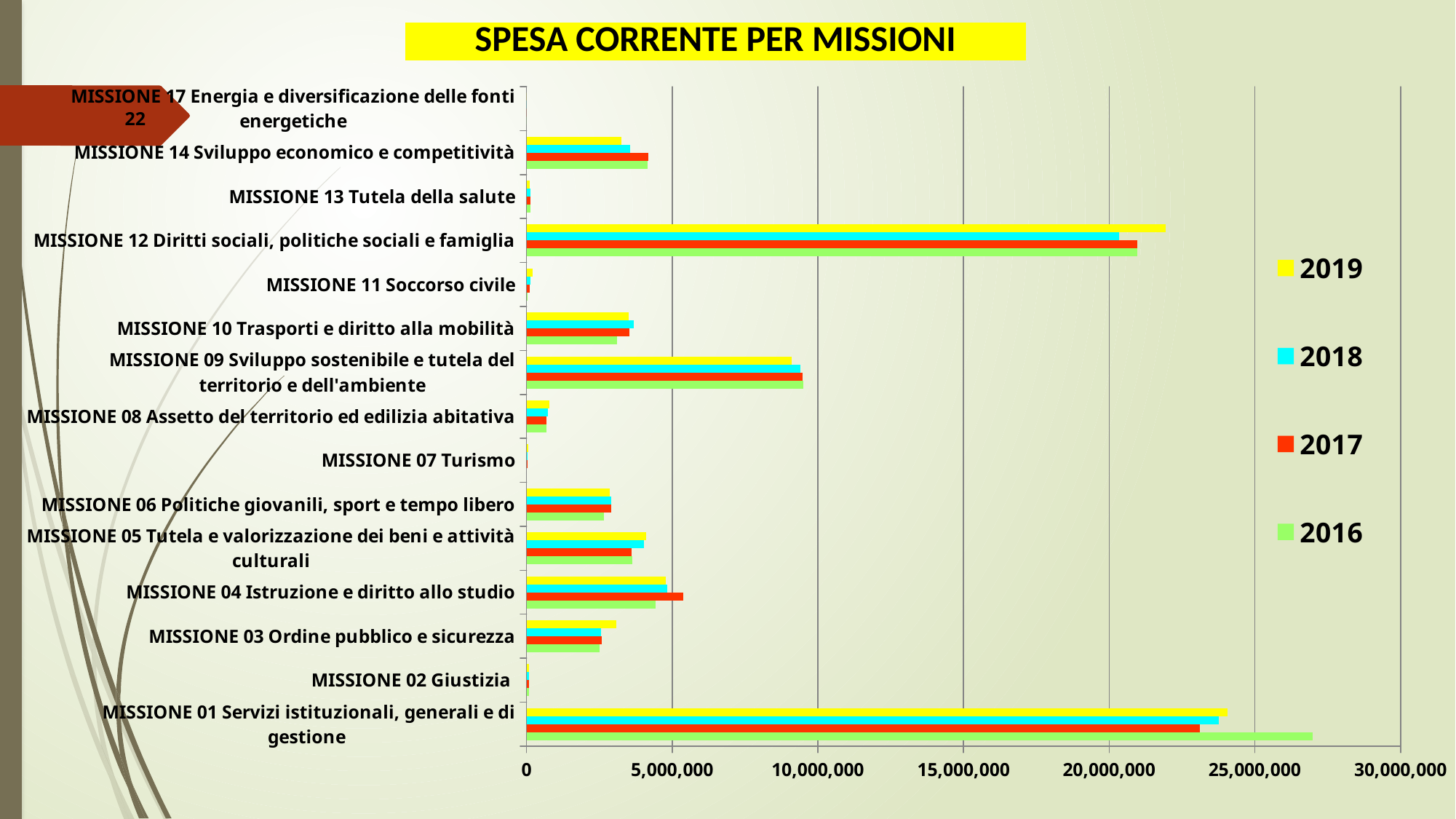
What is the title of the chart? SPESA CORRENTE PER MISSIONI Which mission has a larger 2019 value: MISSIONE 12 Diritti sociali, politiche sociali e famiglia or MISSIONE 09 Sviluppo sostenibile e tutela del territorio e dell'ambiente? MISSIONE 12 Diritti sociali, politiche sociali e famiglia Which mission has the highest 2016 value? MISSIONE 01 Servizi istituzionali, generali e di gestione Is the 2016 value for MISSIONE 01 Servizi istituzionali, generali e di gestione greater or less than 25,000,000? greater What kind of chart is shown on the slide? bar chart For MISSIONE 01 Servizi istituzionali, generali e di gestione, which year has the larger value: 2016 or 2019? 2016 Is the 2019 value for MISSIONE 12 Diritti sociali, politiche sociali e famiglia greater or less than 20,000,000? greater How many missions (categories) are plotted on the chart? 15 Is the 2017 value for MISSIONE 04 Istruzione e diritto allo studio greater or less than 5,000,000? greater Which mission has the highest 2019 value? MISSIONE 01 Servizi istituzionali, generali e di gestione How many series does the legend list? 4